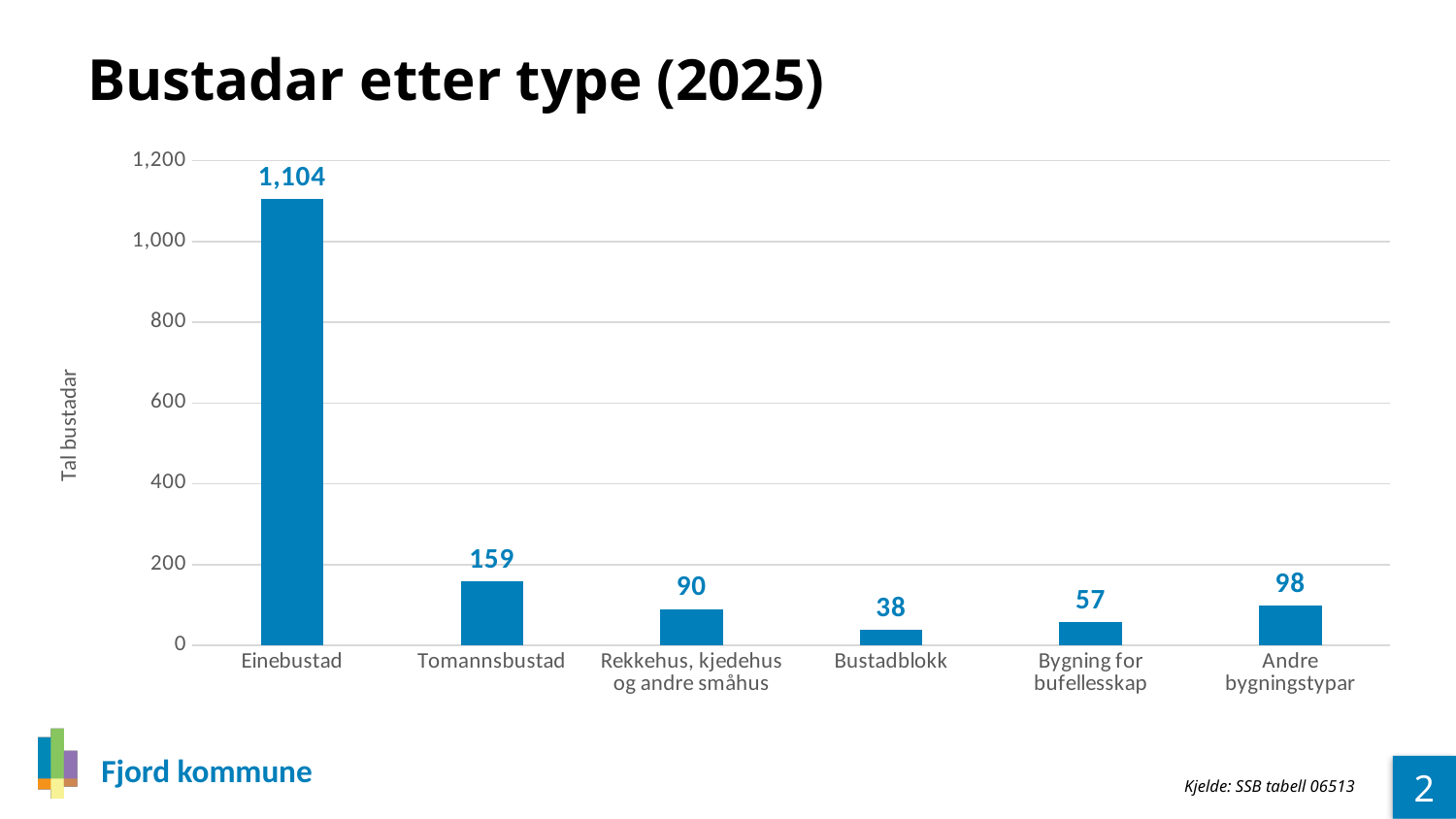
Which is larger, the value for Bygning for bufellesskap or the value for Andre bygningstypar? Andre bygningstypar What is the difference between the values for Tomannsbustad and Rekkehus, kjedehus og andre småhus? 69 What is the title of the chart? Bustadar etter type (2025) How many categories are shown on the x axis? 6 What is the value for Einebustad? 1,104 What kind of chart is shown on the slide? bar chart What is the value for Andre bygningstypar? 98 What is the value for Bustadblokk? 38 Is the value for Einebustad greater or less than 1,000? greater Which category has the lowest value? Bustadblokk What is the value for Tomannsbustad? 159 Which category has the highest value? Einebustad